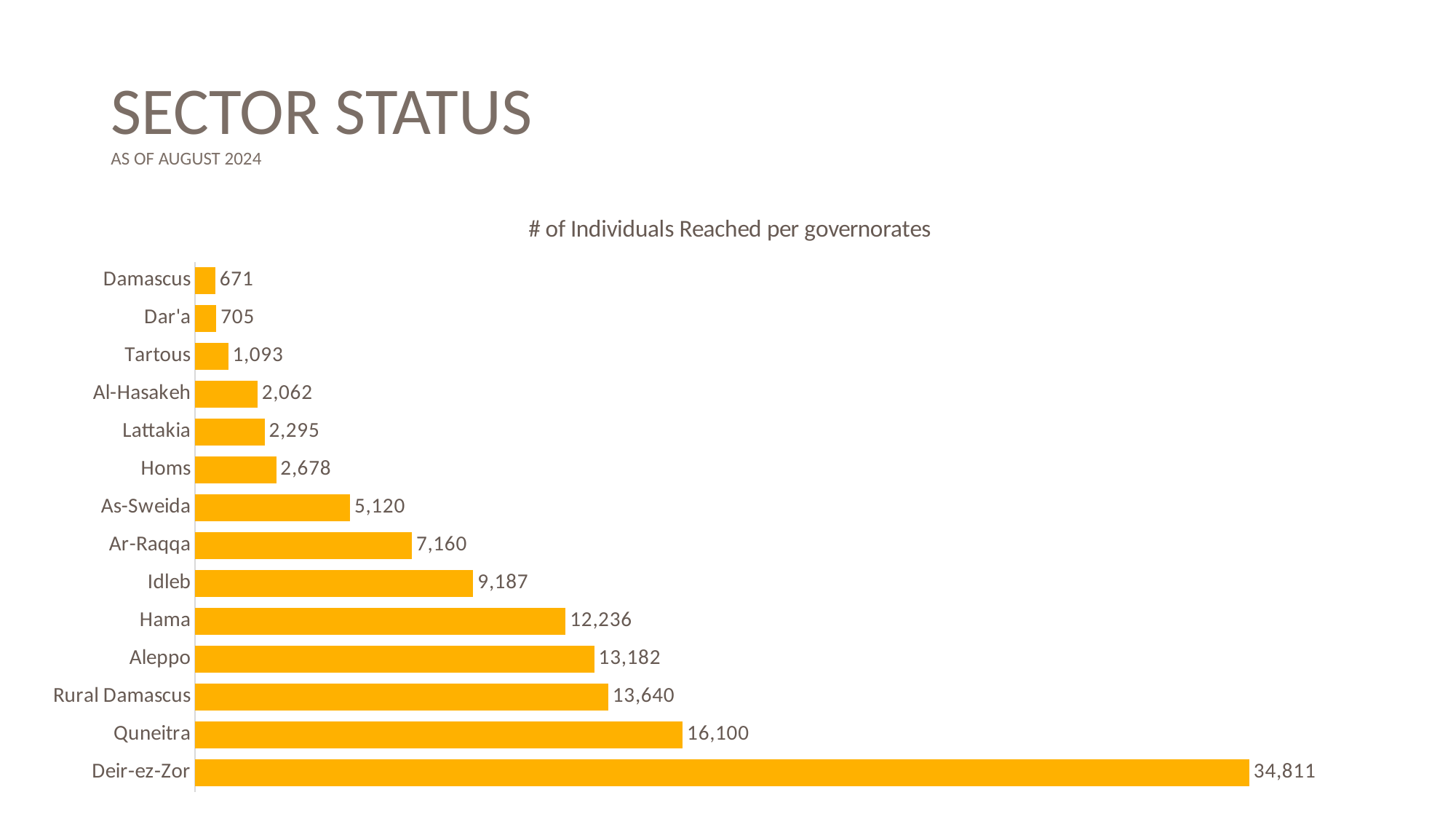
What is the difference between the number of individuals reached in Quneitra and in Rural Damascus? 2,460 What is the difference between the number of individuals reached in Deir-ez-Zor and in Hama? 22,575 Which has more individuals reached, Homs or Lattakia? Homs Which has more individuals reached, Idleb or Ar-Raqqa? Idleb What is the number of individuals reached in Tartous? 1,093 How many governorates are shown in the chart? 14 What type of chart is shown on the slide? Bar chart What is the number of individuals reached in Aleppo? 13,182 What is the number of individuals reached in As-Sweida? 5,120 Which governorate has the highest number of individuals reached? Deir-ez-Zor Which governorate has the lowest number of individuals reached? Damascus What is the title of the chart? # of Individuals Reached per governorates